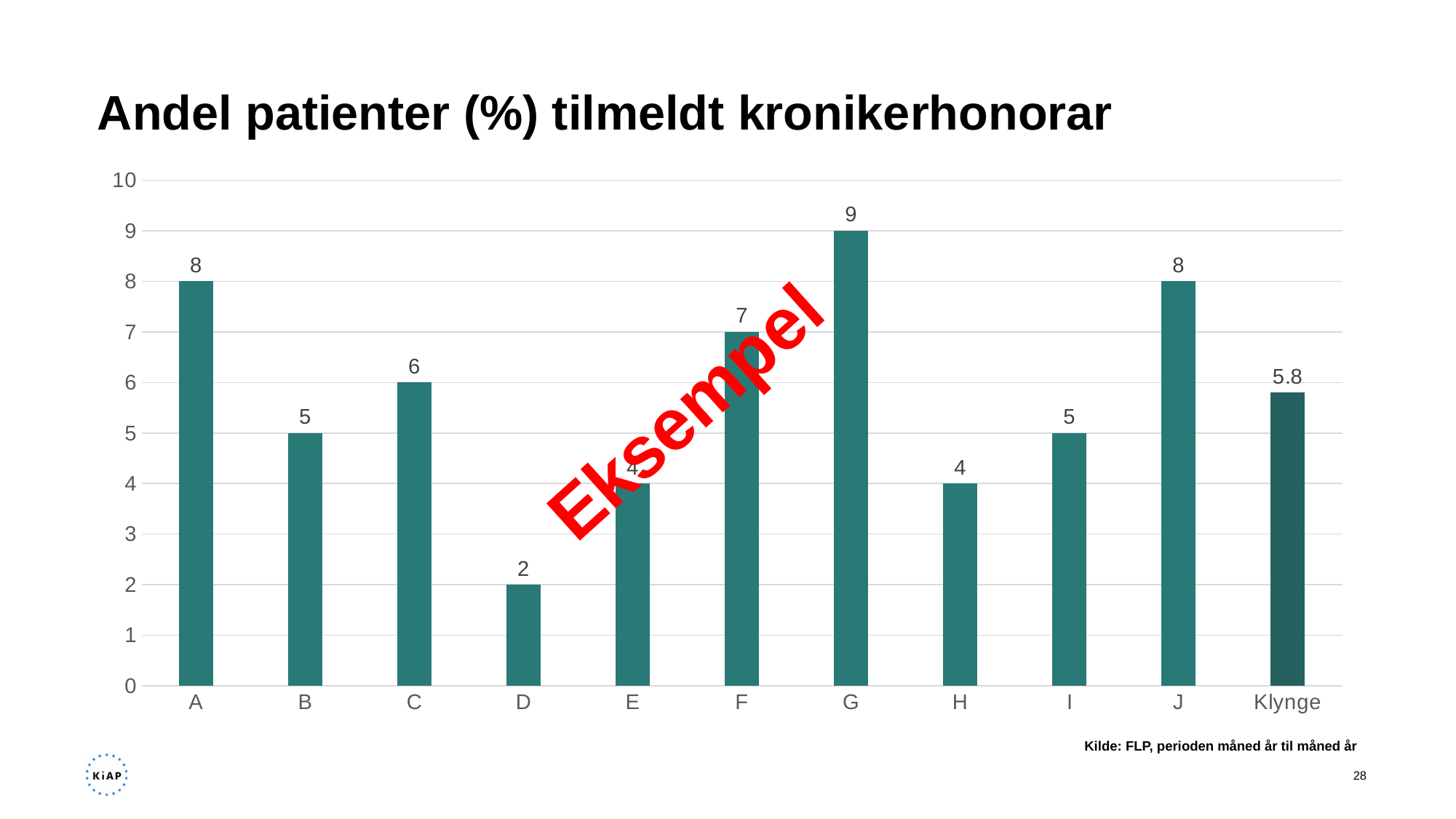
What is the difference between the values for G and D? 7 How many categories are shown on the x axis? 11 What kind of chart is this? bar chart Which category has the lowest value? D What is the difference between the values for A and B? 3 Which is larger, the value for C or the value for H? C What is the value for Klynge? 5.8 What is the value for category G? 9 What is the title of the chart? Andel patienter (%) tilmeldt kronikerhonorar Which category has the highest value? G What is the value for category D? 2 Is the value for F greater or less than 5? greater